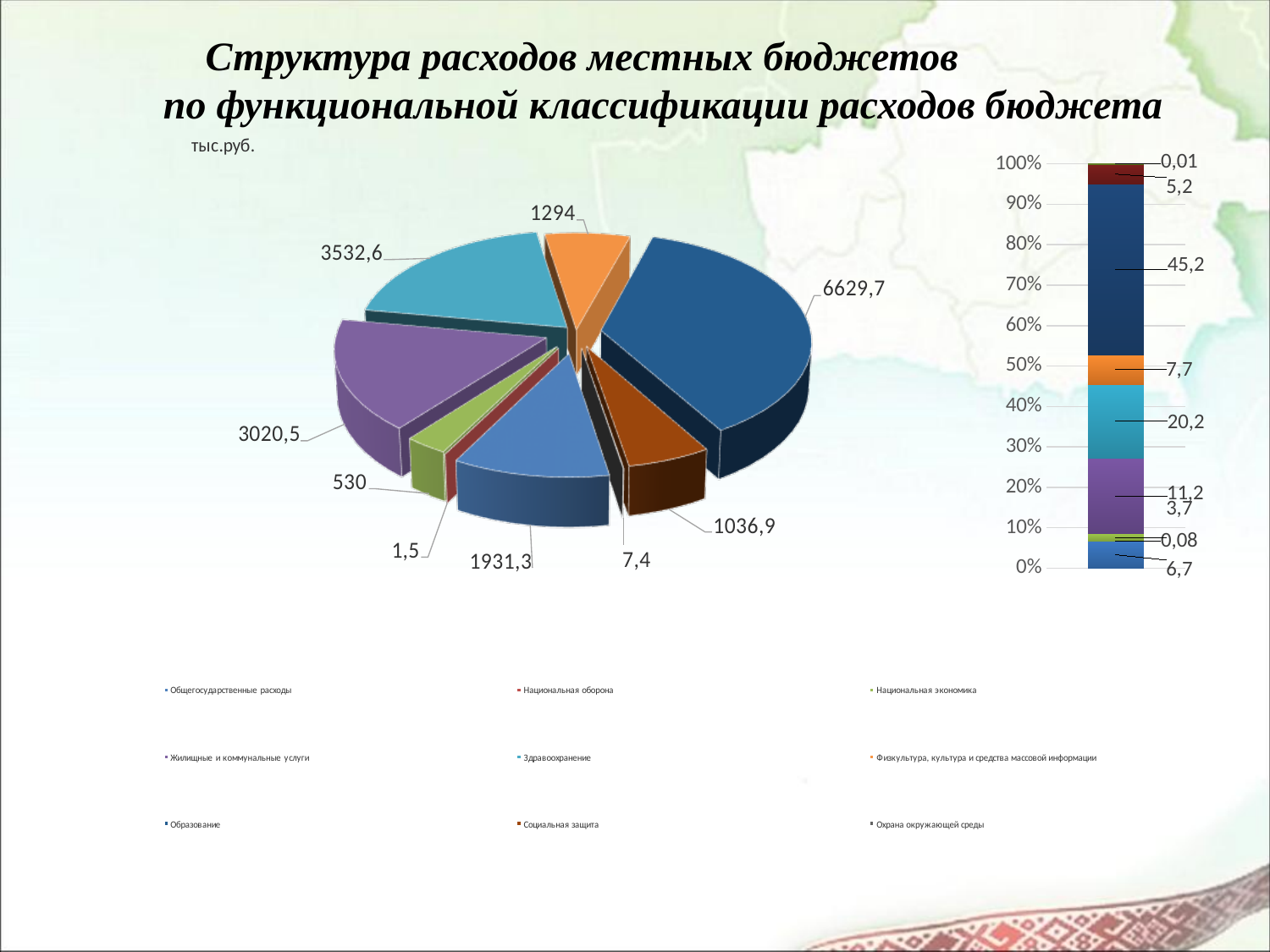
In the stacked bar chart on the right, what is the value of the bottom segment? 6,7 What unit is shown above the pie chart? тыс.руб. In the pie chart, which is larger: the slice labelled 1931,3 or the slice labelled 1294? 1931,3 In the pie chart, what is the difference between the slice labelled 3532,6 and the slice labelled 3020,5? 512,1 How many categories does the legend at the bottom of the slide list? 9 In the stacked bar chart on the right, what is the value of the topmost segment? 0,01 In the pie chart, what is the value of the largest slice? 6629,7 In the pie chart, what is the value of the dark blue slice (Образование)? 6629,7 In the pie chart, what is the value of the smallest slice? 1,5 In the stacked bar chart on the right, what is the value of the largest segment? 45,2 How many slices does the pie chart have? 9 What kind of chart is the chart on the left of the slide? pie chart